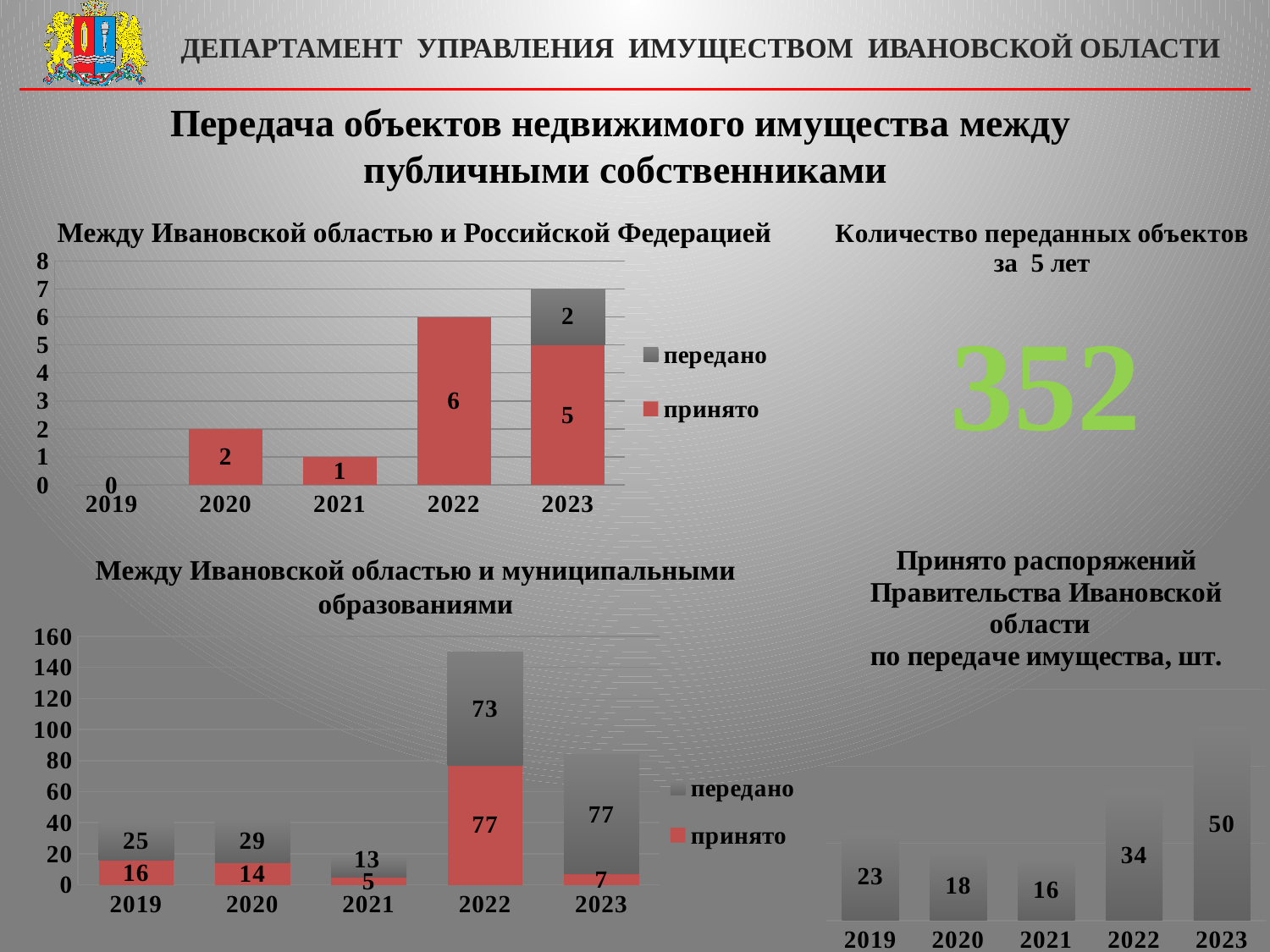
In the chart 'Между Ивановской областью и Российской Федерацией', what is the total of the stacked bar for 2023? 7 What type of chart is 'Принято распоряжений Правительства Ивановской области по передаче имущества, шт.'? bar chart In the chart 'Между Ивановской областью и Российской Федерацией', how many series does the legend list? 2 In the chart 'Между Ивановской областью и Российской Федерацией', what is the value of 'принято' for 2022? 6 In the chart 'Между Ивановской областью и муниципальными образованиями', what is the total of the stacked bar for 2022? 150 In the chart 'Между Ивановской областью и муниципальными образованиями', which year has the highest 'принято' value? 2022 In the chart 'Принято распоряжений Правительства Ивановской области по передаче имущества, шт.', what is the value for 2022? 34 In the chart 'Между Ивановской областью и муниципальными образованиями', what is the difference between 'передано' for 2023 and 'передано' for 2019? 52 In the chart 'Между Ивановской областью и муниципальными образованиями', what is the value of 'принято' for 2021? 5 In the chart 'Между Ивановской областью и муниципальными образованиями', what is the value of 'передано' for 2022? 73 In the chart 'Между Ивановской областью и Российской Федерацией', what is the value of 'передано' for 2023? 2 In the chart 'Принято распоряжений Правительства Ивановской области по передаче имущества, шт.', which year has the lowest value? 2021